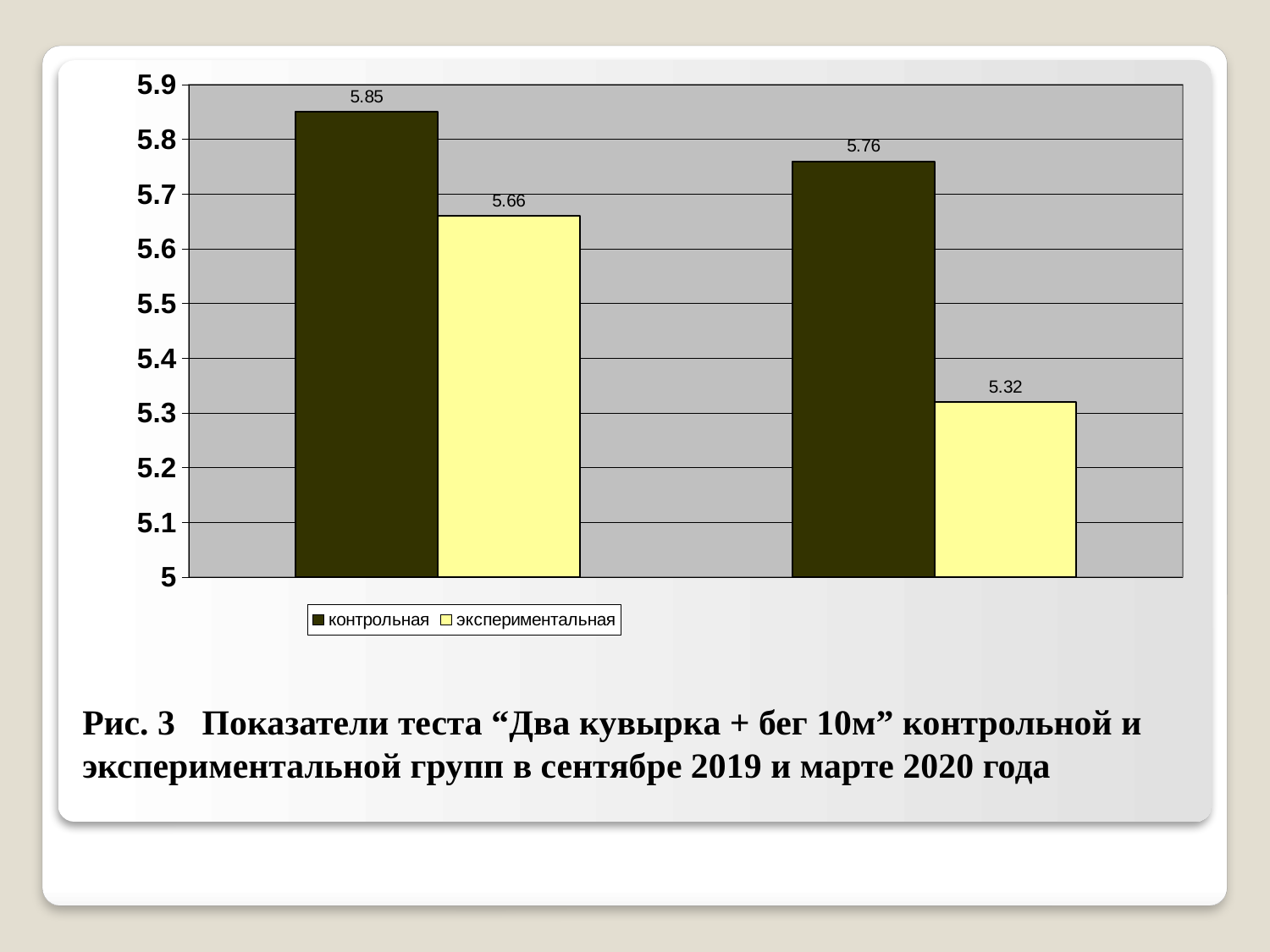
How many series does the legend list? 2 What is the value of the контрольная bar in the left group of bars? 5.85 Which bar on the chart has the highest value? контрольная in the left group (5.85) What is the difference between the контрольная and экспериментальная bars in the right group? 0.44 What colour are the экспериментальная bars? light yellow What is the value of the контрольная bar in the right group of bars? 5.76 What is the value of the экспериментальная bar in the left group of bars? 5.66 What is the difference between the контрольная and экспериментальная bars in the left group? 0.19 Which bar on the chart has the lowest value? экспериментальная in the right group (5.32) What kind of chart is shown on the slide? bar chart What is the value of the экспериментальная bar in the right group of bars? 5.32 In the right group of bars, which is larger: контрольная or экспериментальная? контрольная